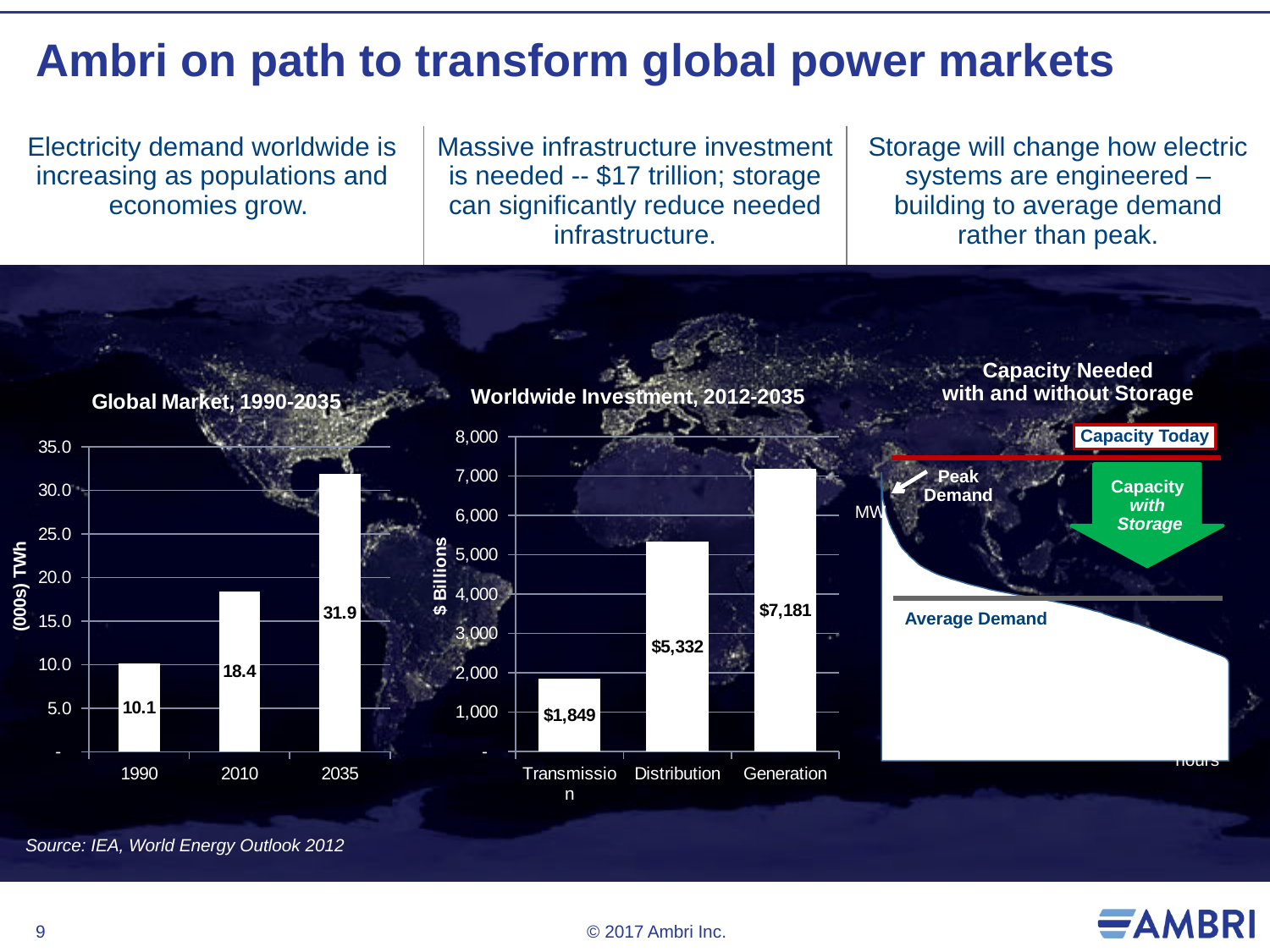
In the 'Global Market, 1990-2035' chart, what is the y-axis label? (000s) TWh In the 'Worldwide Investment, 2012-2035' chart, what is the difference between Generation and Transmission? $5,332 In the 'Global Market, 1990-2035' chart, what is the value for 2035? 31.9 In the 'Worldwide Investment, 2012-2035' chart, is the value for Transmission greater or less than 2,000? less In the 'Worldwide Investment, 2012-2035' chart, what is the value for Distribution? $5,332 In the 'Worldwide Investment, 2012-2035' chart, which category has the highest value? Generation What kind of chart is the 'Worldwide Investment, 2012-2035' chart? bar chart In the 'Worldwide Investment, 2012-2035' chart, how many categories are shown? 3 In the 'Global Market, 1990-2035' chart, what is the difference between the 2035 and 2010 values? 13.5 In the 'Global Market, 1990-2035' chart, which year has the lowest value? 1990 In the 'Global Market, 1990-2035' chart, do the values rise or fall from 1990 to 2035? rise In the 'Global Market, 1990-2035' chart, what is the value for 1990? 10.1